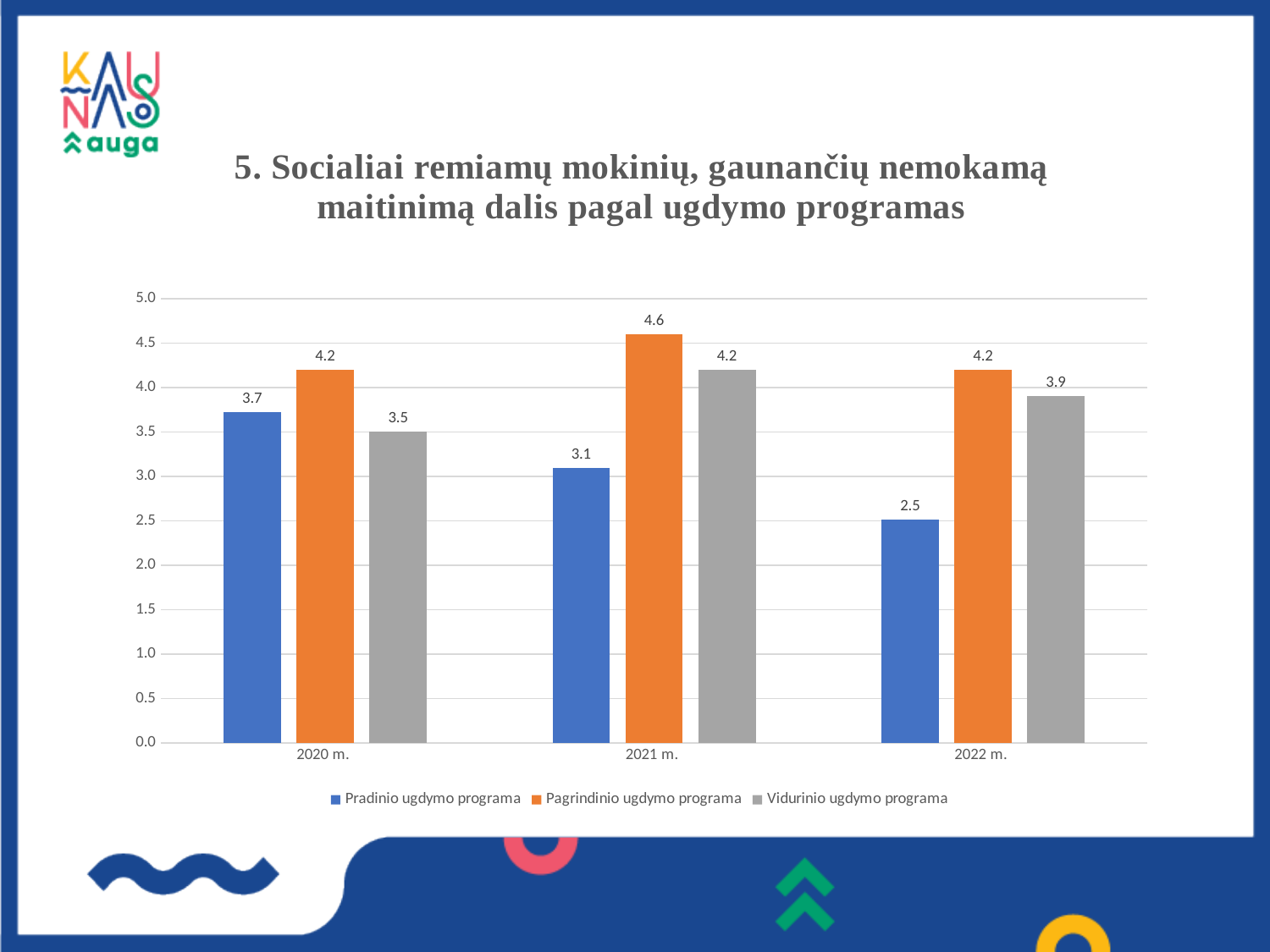
How many years are shown on the x axis? 3 What kind of chart is shown on the slide? Bar chart How many series does the legend list? 3 In which year is the value for Pradinio ugdymo programa lowest? 2022 m. Does the value for Pradinio ugdymo programa rise or fall from 2020 m. to 2022 m.? Fall In which year is the value for Pagrindinio ugdymo programa highest? 2021 m. What is the difference between Pagrindinio ugdymo programa and Pradinio ugdymo programa in 2021 m.? 1.5 What is the value for Pradinio ugdymo programa in 2022 m.? 2.5 What is the value for Pradinio ugdymo programa in 2020 m.? 3.7 What is the value for Pagrindinio ugdymo programa in 2021 m.? 4.6 What is the value for Vidurinio ugdymo programa in 2022 m.? 3.9 Which is larger in 2020 m.: Pradinio ugdymo programa or Vidurinio ugdymo programa? Pradinio ugdymo programa